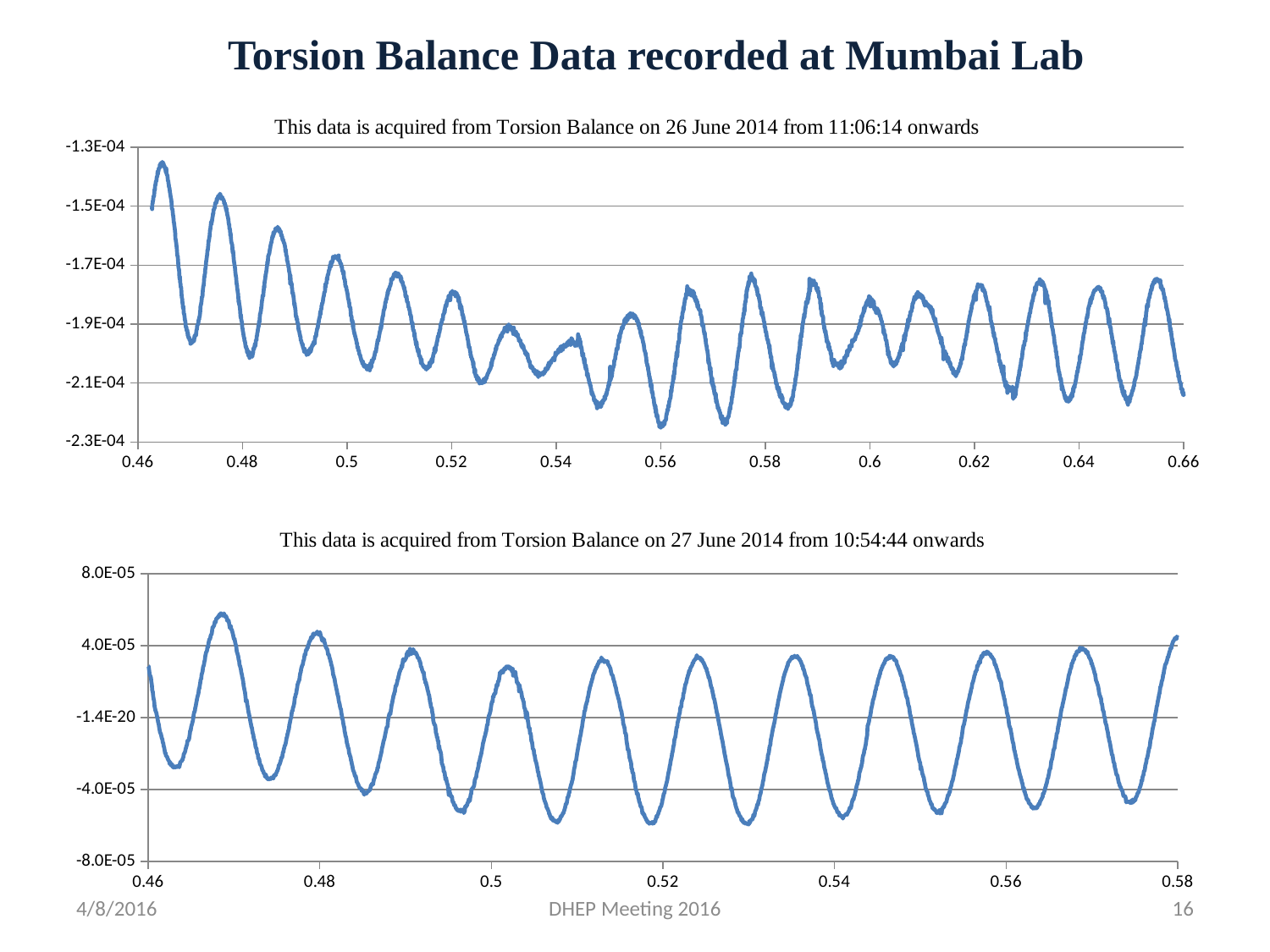
On which date was the data in the top chart acquired? 26 June 2014 What kind of chart is the bottom chart, titled 'This data is acquired from Torsion Balance on 27 June 2014 from 10:54:44 onwards'? line chart On the bottom chart (27 June 2014), do the peak values rise or fall as x goes from 0.47 to 0.50? fall On the top chart (26 June 2014), is the value of the peak near x = 0.655 greater or less than -1.9E-04? greater On the top chart (26 June 2014), is the value of the trough near x = 0.56 greater or less than -2.1E-04? less On the bottom chart (27 June 2014), is the value of the first peak near x = 0.468 greater or less than 4.0E-05? greater On the top chart (26 June 2014), do the peak values rise or fall as x goes from 0.46 to 0.52? fall What kind of chart is the top chart, titled 'This data is acquired from Torsion Balance on 26 June 2014 from 11:06:14 onwards'? line chart What is the largest x-axis value shown on the bottom chart (27 June 2014)? 0.58